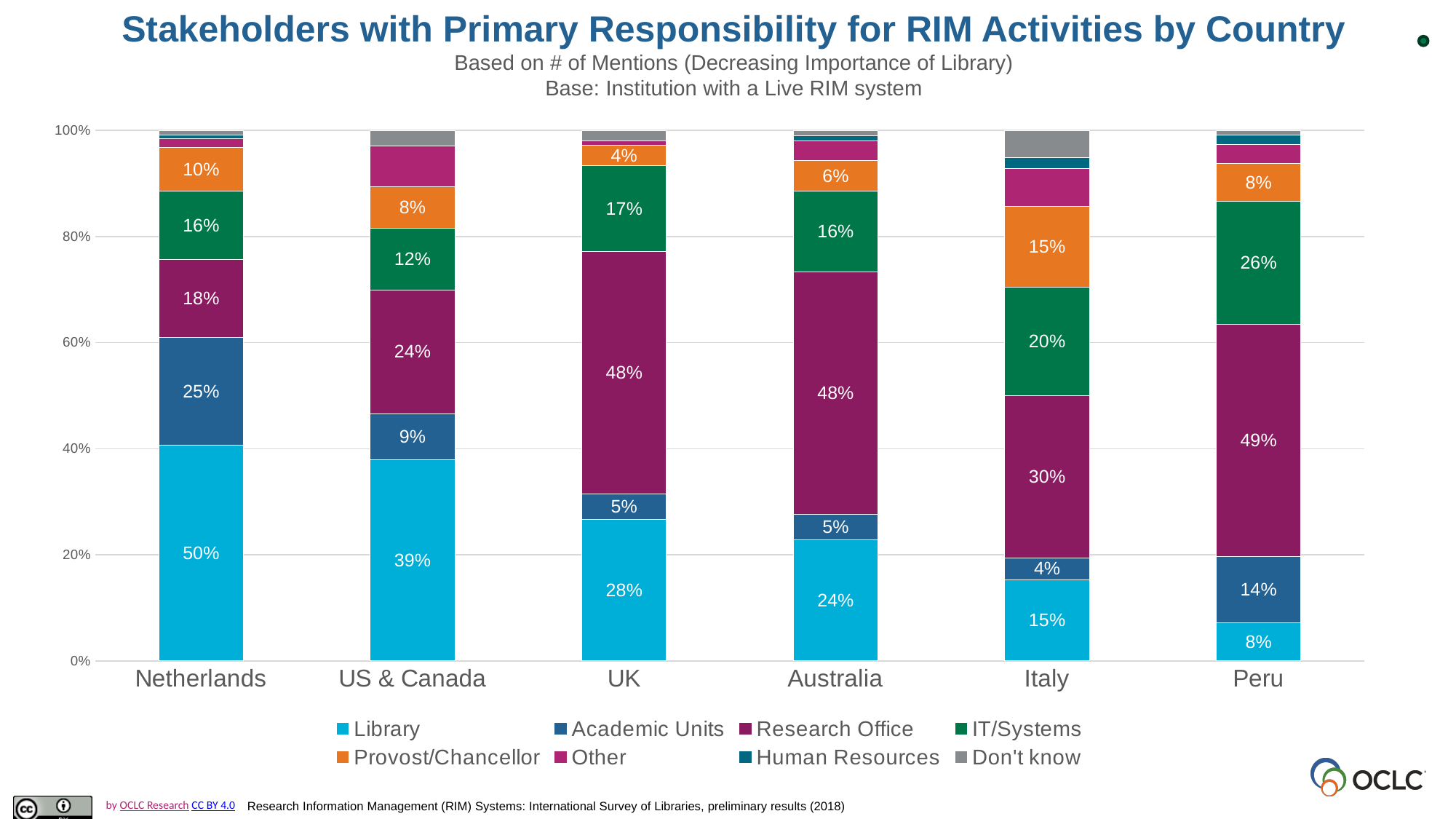
What is the Research Office share for Peru? 49% Which country has the highest Library share? Netherlands Does the Library share rise or fall moving from Netherlands to Peru along the x axis? Fall What is the difference between the Library share in the Netherlands and in Peru? 42 percentage points Which is larger: the Academic Units share in the Netherlands or in Peru? Netherlands What kind of chart is shown on the slide? Stacked bar chart What is the IT/Systems value for Italy? 20% How many countries or regions are shown on the x axis? 6 What is the Provost/Chancellor value for the UK? 4% What percentage of mentions does the Library account for in the Netherlands? 50% Which country has the lowest Library share? Peru How many series does the legend list? 8